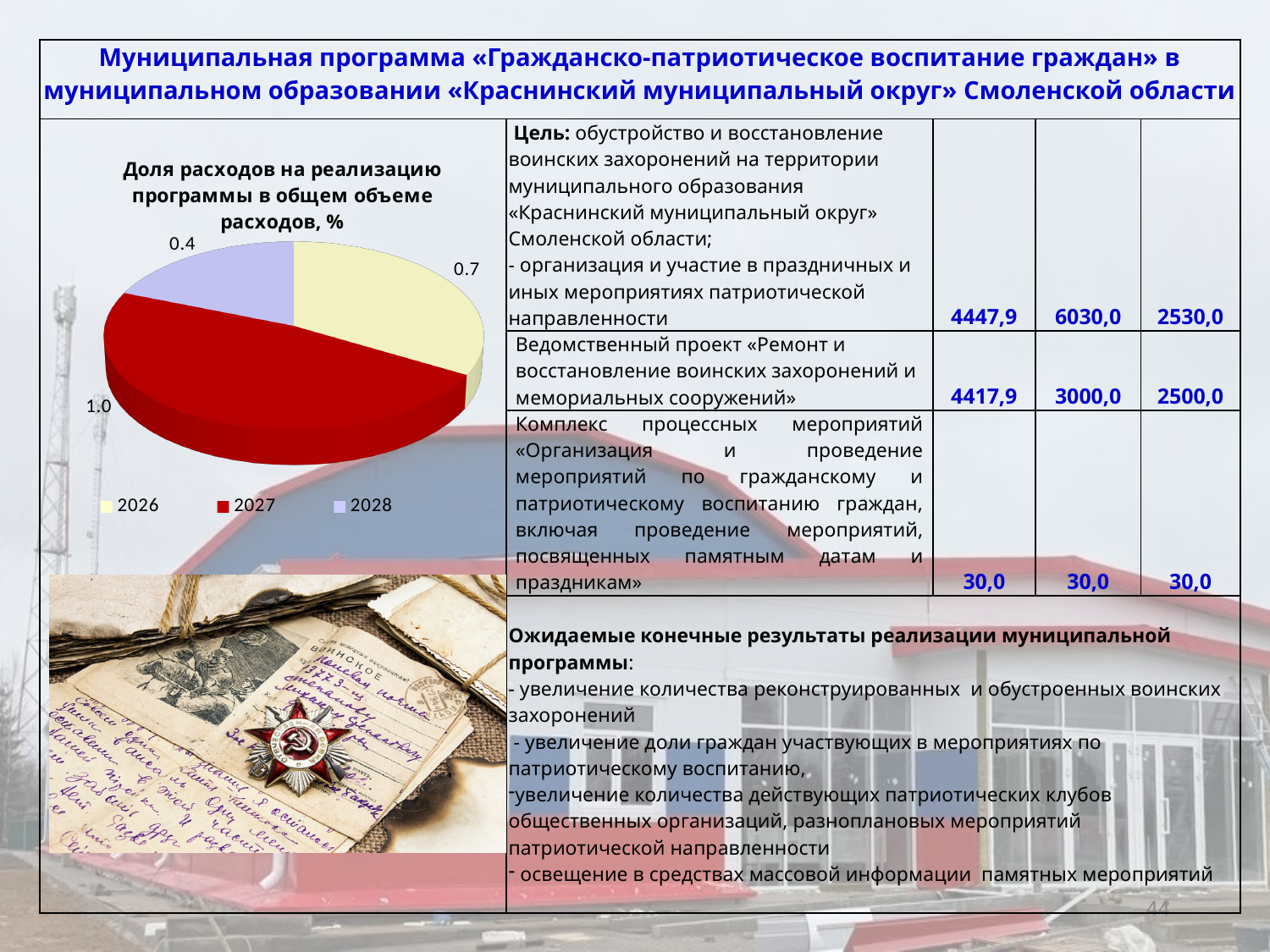
Which year has the smallest slice in the pie chart? 2028 What type of chart is shown on the slide? pie chart What value is shown for 2026 in the pie chart? 0.7 What is the difference between the values for 2027 and 2026 in the pie chart? 0.3 What is the difference between the values for 2027 and 2028 in the pie chart? 0.6 Which year has the largest slice in the pie chart? 2027 What is the title of the pie chart? Доля расходов на реализацию программы в общем объеме расходов, % Which is larger in the pie chart, the value for 2026 or the value for 2028? 2026 How many slices does the pie chart have? 3 Which colour represents 2027 in the pie chart legend? red What value is shown for 2027 in the pie chart? 1.0 What value is shown for 2028 in the pie chart? 0.4